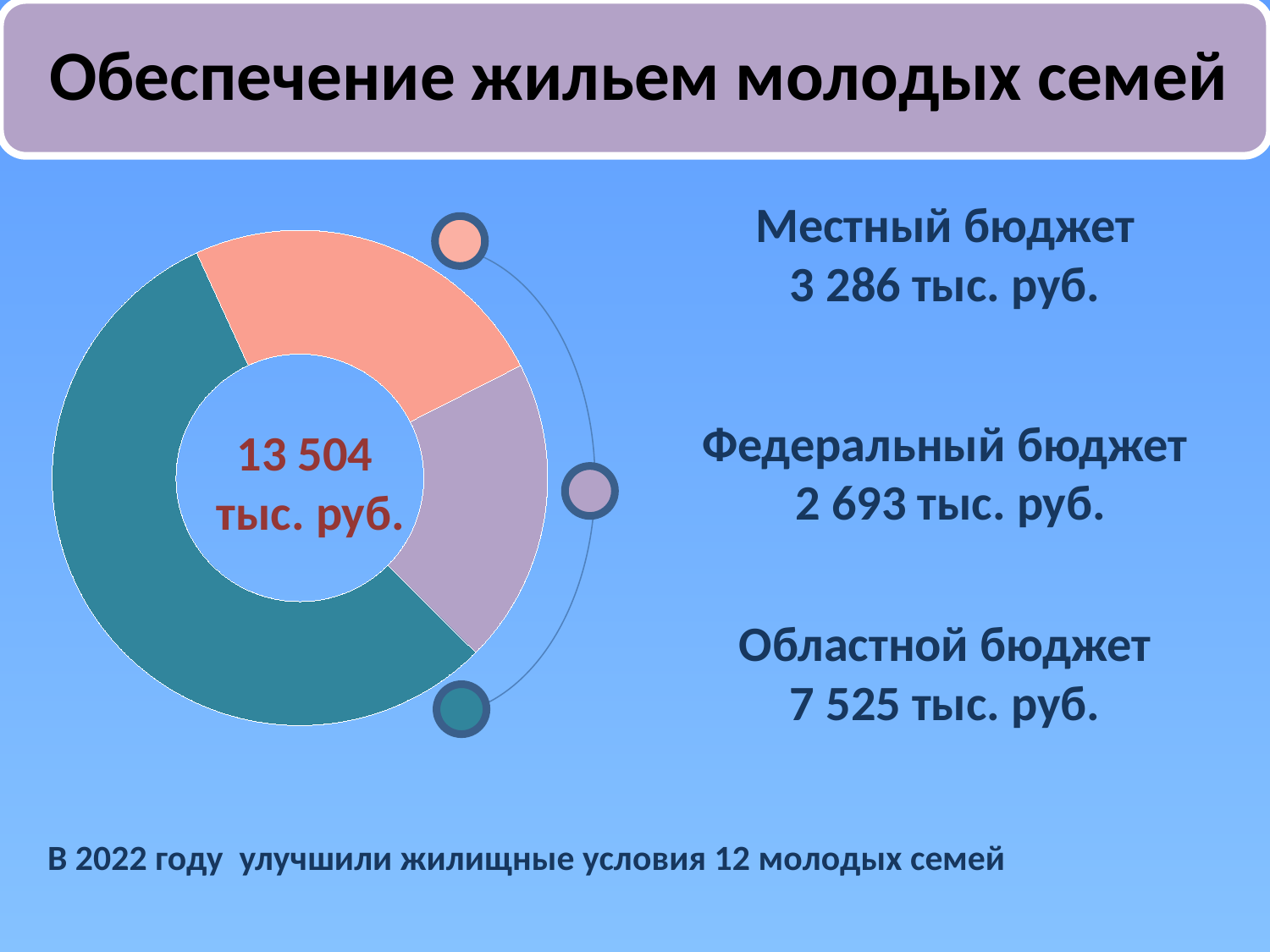
What is the difference between Местный бюджет and Федеральный бюджет? 593 тыс. руб. Which is larger, Местный бюджет or Федеральный бюджет? Местный бюджет What is the total value shown in the centre of the chart? 13 504 тыс. руб. What colour is the segment for Областной бюджет? Teal What is the value for Федеральный бюджет in the chart? 2 693 тыс. руб. What is the value for Местный бюджет in the chart? 3 286 тыс. руб. Which budget source has the largest segment in the chart? Областной бюджет What is the value for Областной бюджет in the chart? 7 525 тыс. руб. How many segments does the chart have? 3 What is the difference between Областной бюджет and Местный бюджет? 4 239 тыс. руб. Which budget source has the smallest segment in the chart? Федеральный бюджет What kind of chart is shown on the slide? Donut (pie) chart